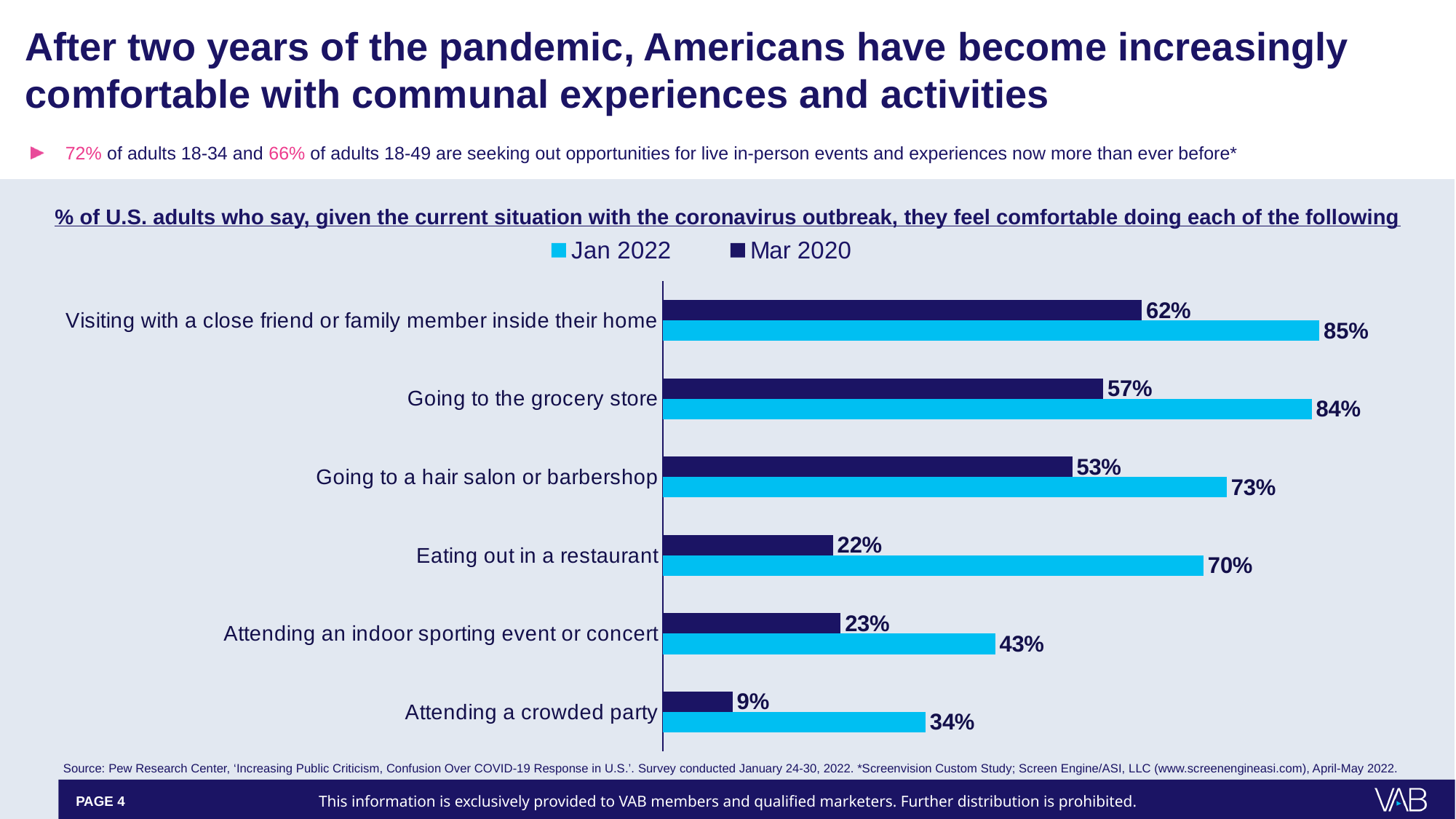
What is the difference between the Jan 2022 and Mar 2020 values for going to a hair salon or barbershop? 20 percentage points How many series does the legend list? 2 What percentage of U.S. adults said they feel comfortable eating out in a restaurant in Jan 2022? 70% How many activities are shown in the chart? 6 Which activity has the lowest Mar 2020 value? Attending a crowded party Which activity has the highest Jan 2022 value? Visiting with a close friend or family member inside their home What is the difference between the Jan 2022 and Mar 2020 values for eating out in a restaurant? 48 percentage points What is the Jan 2022 value for going to the grocery store? 84% What percentage of U.S. adults said they feel comfortable attending a crowded party in Mar 2020? 9% Which is larger: the Mar 2020 value for eating out in a restaurant or the Mar 2020 value for attending an indoor sporting event or concert? Attending an indoor sporting event or concert What kind of chart is shown on the slide? Bar chart Which colour represents the Jan 2022 series in the chart? Light blue